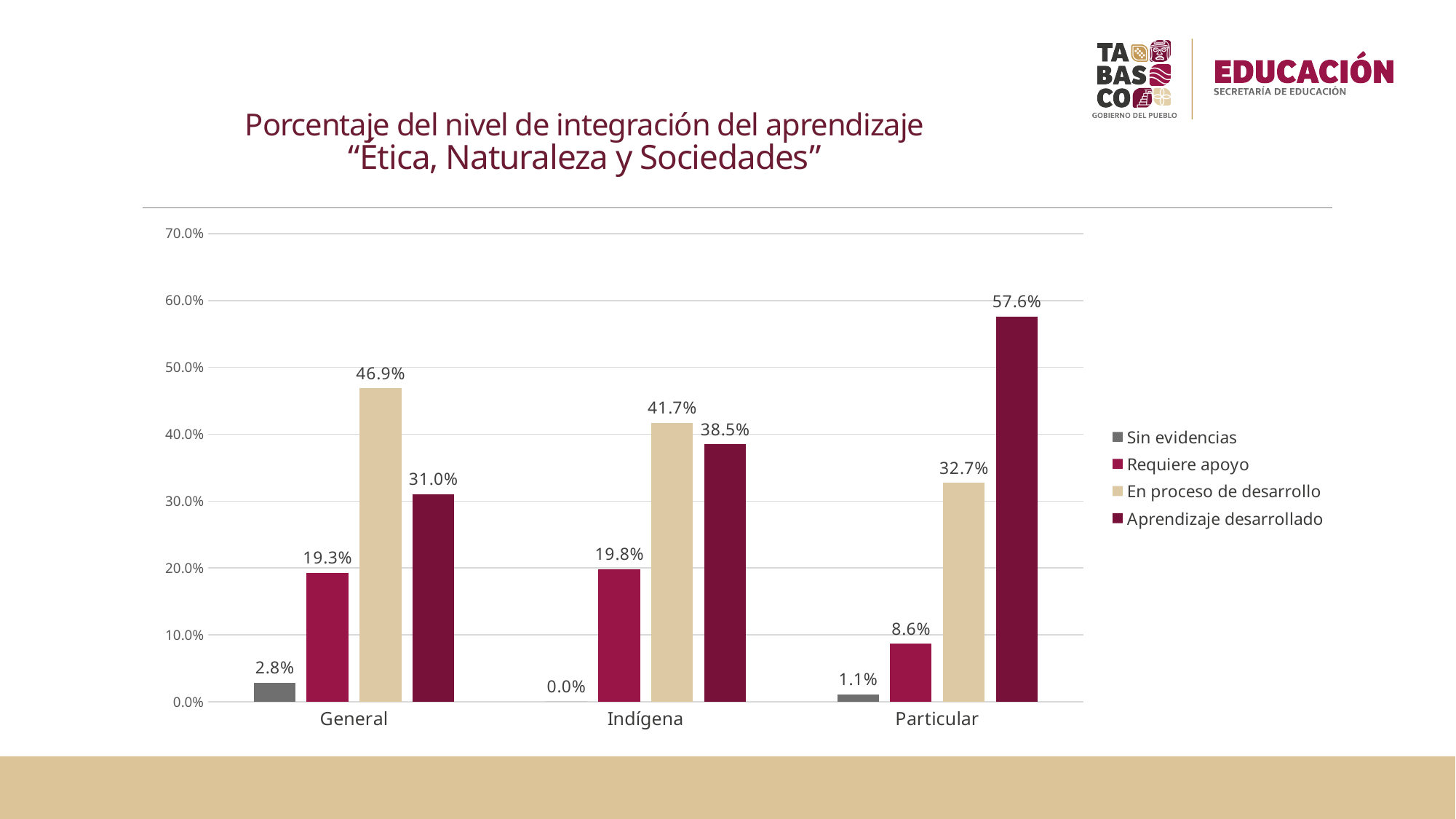
Which series is shown in grey in the legend? Sin evidencias Which category has the lowest value for "En proceso de desarrollo"? Particular Which category has the highest value for "Aprendizaje desarrollado"? Particular What is the value for "Requiere apoyo" in the Particular category? 8.6% What is the value for "Aprendizaje desarrollado" in the Particular category? 57.6% What kind of chart is shown on the slide? Bar chart What is the value for "En proceso de desarrollo" in the General category? 46.9% Which is larger in the Indígena category: "En proceso de desarrollo" or "Aprendizaje desarrollado"? En proceso de desarrollo How many categories are shown on the x axis? 3 How many series does the legend list? 4 What is the difference between "En proceso de desarrollo" and "Aprendizaje desarrollado" in the General category? 15.9% What is the value for "Sin evidencias" in the Indígena category? 0.0%